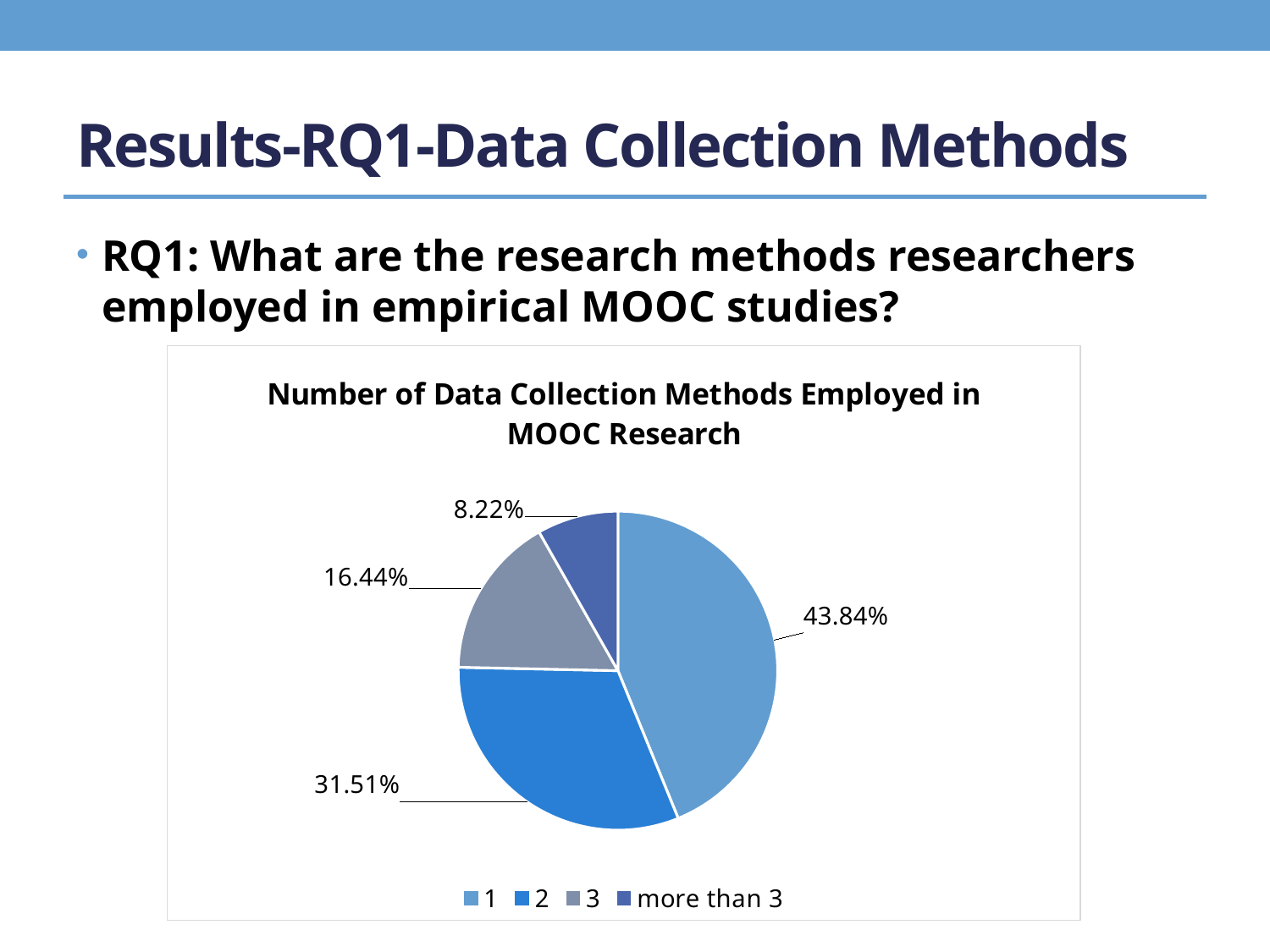
What share of the pie does the category "1" represent? 43.84% What share of the pie does the category "2" represent? 31.51% Which category has the smallest slice of the pie? more than 3 Which category has the largest slice of the pie? 1 How many categories does the pie chart show? 4 What is the title of the chart? Number of Data Collection Methods Employed in MOOC Research What share of the pie does the category "3" represent? 16.44% What is the difference in percentage points between the slices for "1" and "2"? 12.33 Which is larger, the slice for "3" or the slice for "more than 3"? 3 How many entries does the legend list? 4 What type of chart is shown on the slide? pie chart